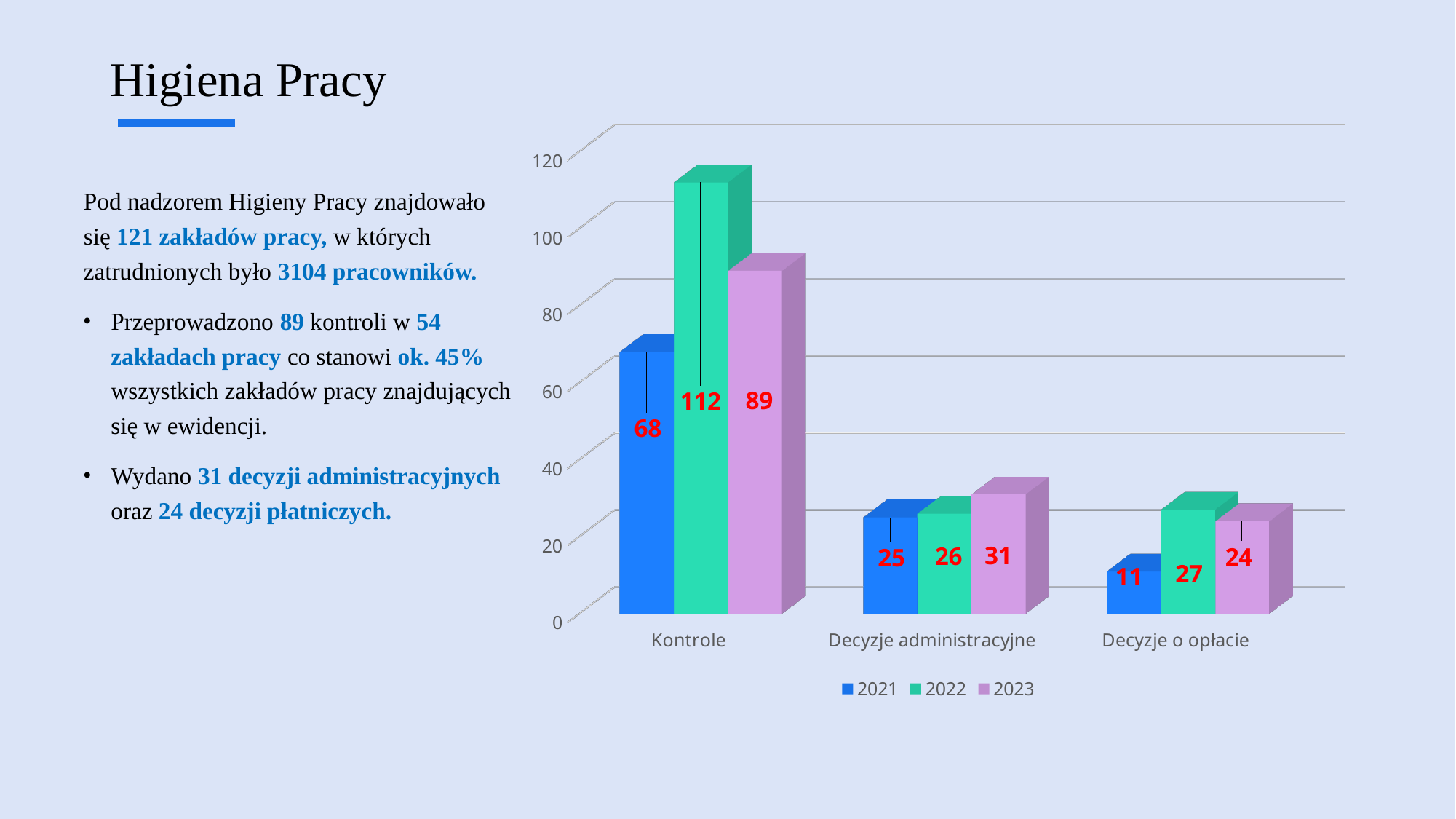
What is the value for Decyzje administracyjne in 2023? 31 What kind of chart is shown on the slide? bar chart What is the difference between the 2022 and 2021 values for Kontrole? 44 How many categories are shown on the x axis? 3 How many series does the legend list? 3 What is the value for Kontrole in 2022? 112 Which category has the lowest value for 2021? Decyzje o opłacie Which series is shown in pink in the legend? 2023 Is the value for Kontrole in 2023 greater or less than 80? greater Which is larger: the 2023 value for Decyzje administracyjne or the 2023 value for Decyzje o opłacie? Decyzje administracyjne What is the value for Decyzje o opłacie in 2021? 11 Which year has the highest value for Kontrole? 2022